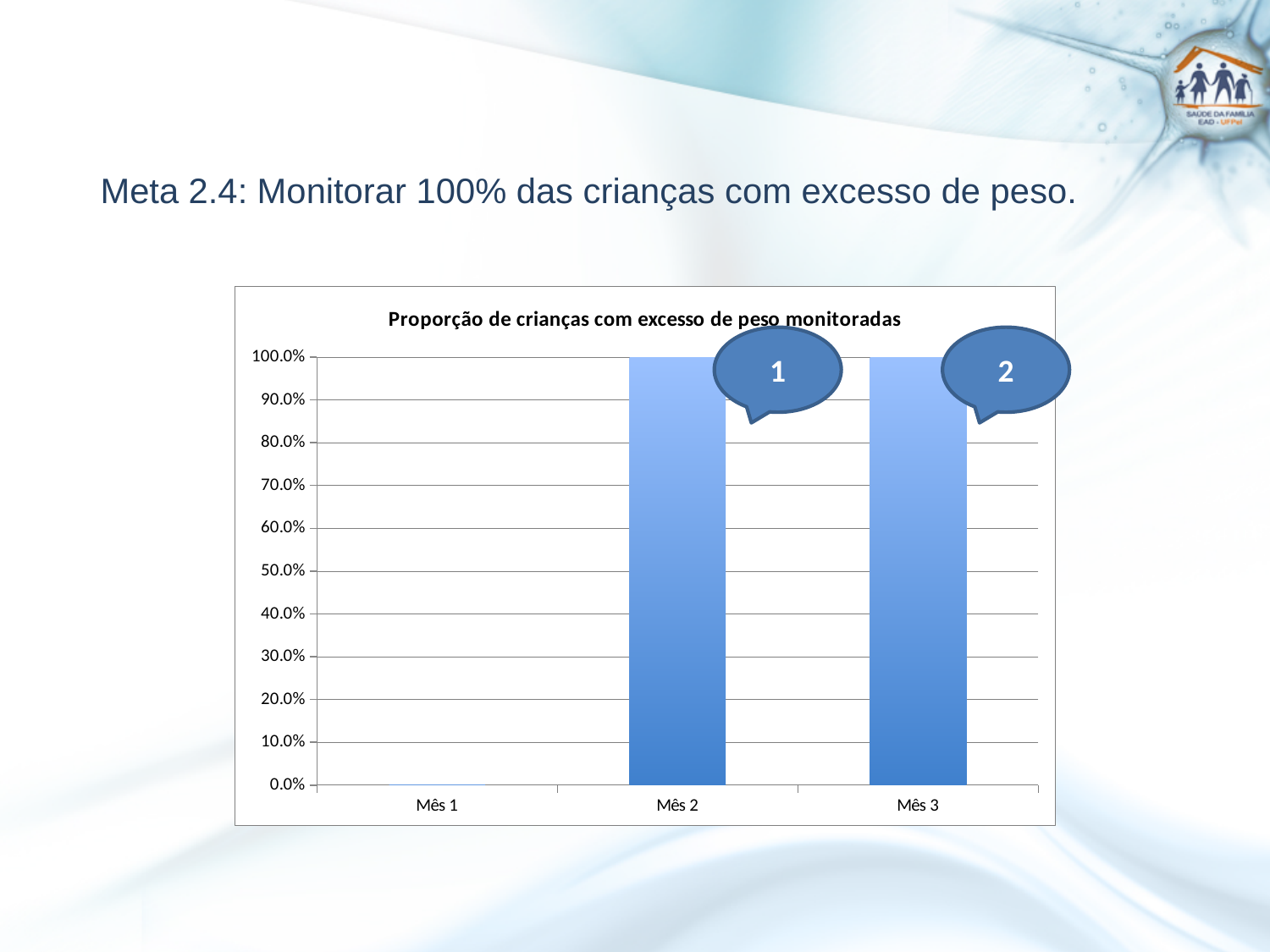
What is the title of the chart? Proporção de crianças com excesso de peso monitoradas What is the value for Mês 1? 0.0% What is the difference between the values for Mês 2 and Mês 1? 100.0% Which month has the lowest value? Mês 1 What kind of chart is shown on the slide? bar chart Does the value rise or fall from Mês 1 to Mês 2? rise What is the value for Mês 2? 100.0% How many categories are shown on the x axis of the chart? 3 Which is larger, the value for Mês 1 or the value for Mês 2? Mês 2 What is the value for Mês 3? 100.0% What number is shown in the callout next to the Mês 3 bar? 2 Is the value for Mês 3 greater or less than 50.0%? greater